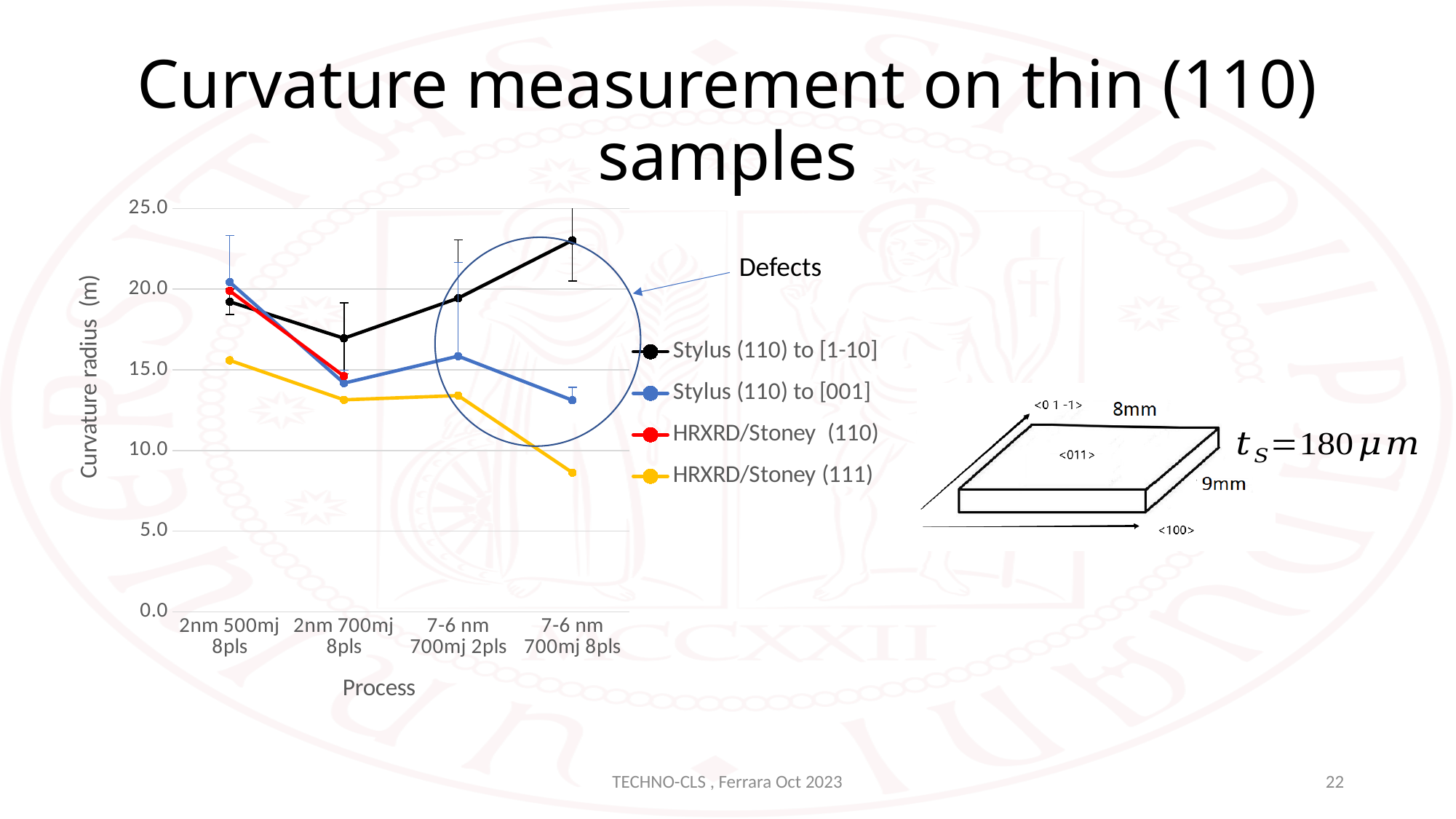
For which process is the HRXRD/Stoney (111) curvature radius lowest? 7-6 nm 700mj 8pls Does the HRXRD/Stoney (111) series rise or fall overall from the first process to the last? fall At 7-6 nm 700mj 8pls, which series has the larger value: Stylus (110) to [1-10] or Stylus (110) to [001]? Stylus (110) to [1-10] How many series does the chart legend list? 4 Is the value for Stylus (110) to [1-10] at 7-6 nm 700mj 8pls greater or less than 20.0? greater What is the label of the y axis? Curvature radius (m) Is the value for HRXRD/Stoney (111) at 7-6 nm 700mj 8pls greater or less than 10.0? less For which process is the Stylus (110) to [001] curvature radius lowest? 7-6 nm 700mj 8pls What kind of chart is shown on the slide? line chart For which process is the Stylus (110) to [1-10] curvature radius highest? 7-6 nm 700mj 8pls How many process categories are shown on the x axis? 4 Is the value for Stylus (110) to [1-10] at 2nm 700mj 8pls greater or less than 15.0? greater